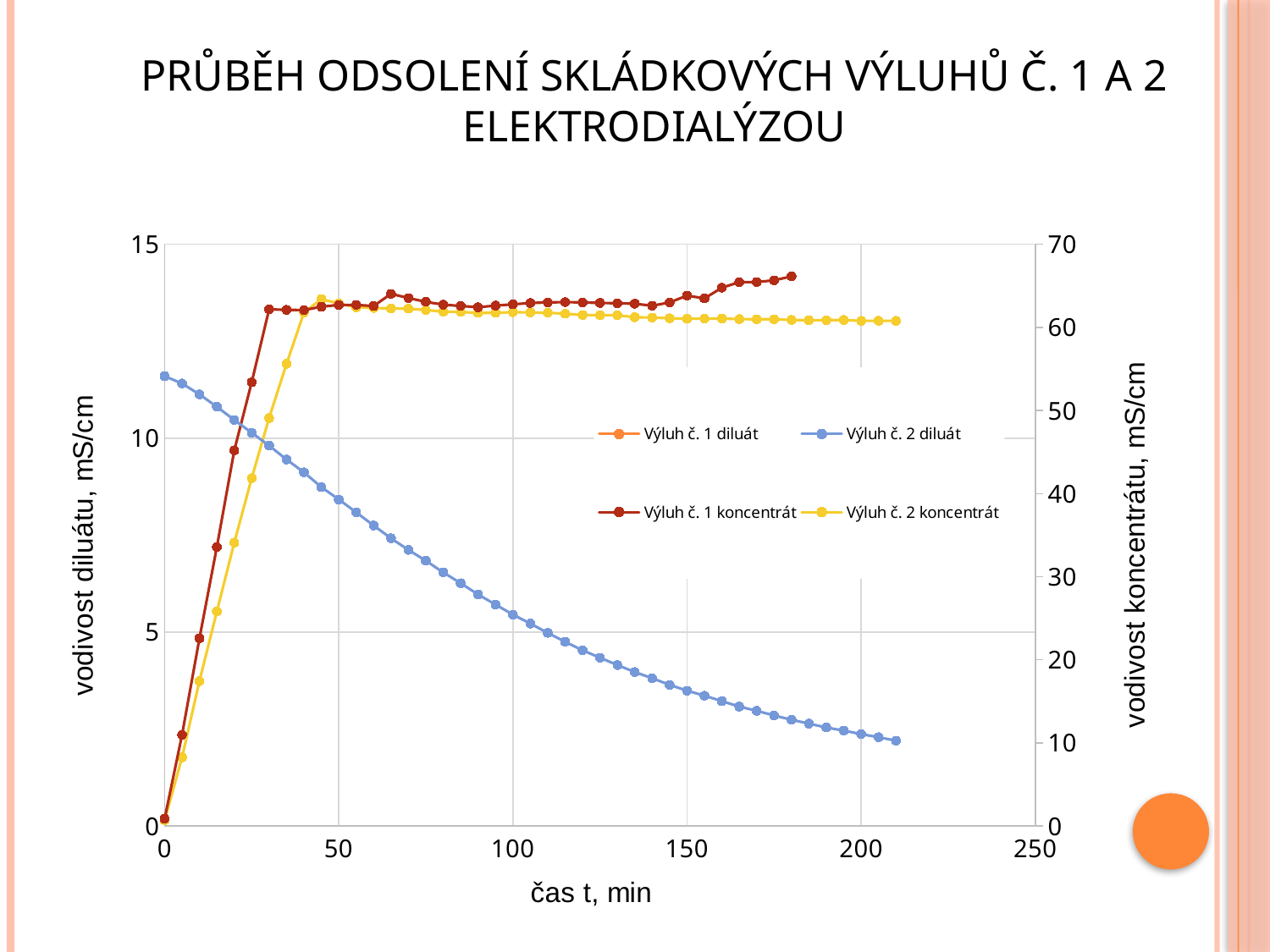
Is the value of Výluh č. 2 diluát at 210 min greater or less than 5 mS/cm on the left axis? less What kind of chart is shown on the slide? line chart Does the Výluh č. 1 koncentrát series rise or fall over the first 30 minutes? rise Which series is drawn in blue? Výluh č. 2 diluát What is the label of the x axis? čas t, min Is the value of Výluh č. 2 diluát at 0 min greater or less than 10 mS/cm on the left axis? greater At 20 min, which series has the higher value: Výluh č. 1 koncentrát or Výluh č. 2 koncentrát? Výluh č. 1 koncentrát Does the Výluh č. 2 diluát series rise or fall as time increases? fall Is the value of Výluh č. 1 koncentrát at 180 min greater or less than 60 mS/cm on the right axis? greater What is the title of the chart on the slide? PRŮBĚH ODSOLENÍ SKLÁDKOVÝCH VÝLUHŮ Č. 1 A 2 ELEKTRODIALÝZOU How many series does the legend list? 4